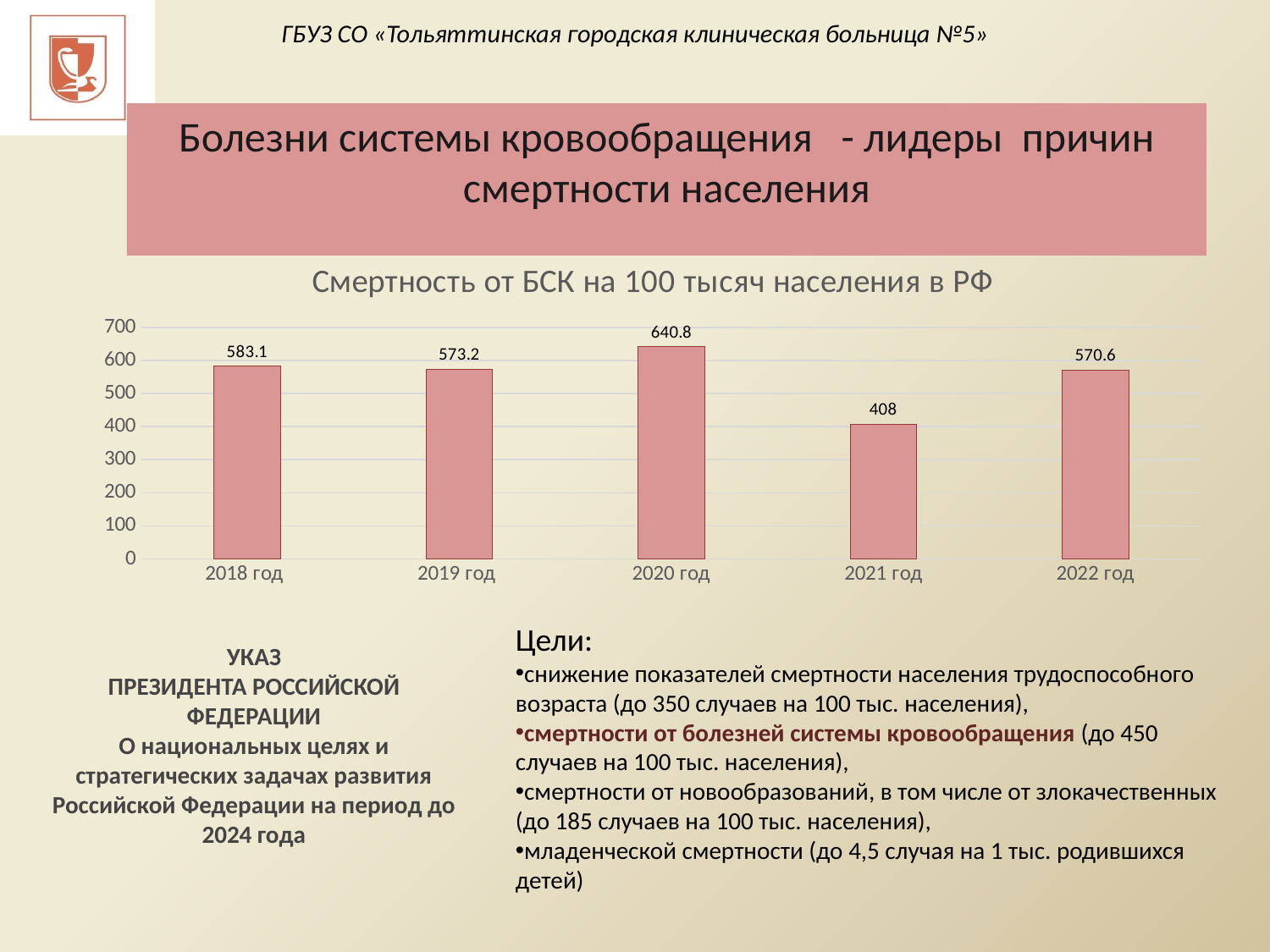
What is the value for 2022 год? 570.6 Is the value for 2021 год greater or less than 500? less Which year has the highest value? 2020 год What is the difference between the values for 2020 год and 2021 год? 232.8 What is the title of the chart? Смертность от БСК на 100 тысяч населения в РФ What is the value for 2018 год? 583.1 What is the value for 2021 год? 408 How many years are shown on the chart? 5 What is the difference between the values for 2018 год and 2019 год? 9.9 Which year has the lowest value? 2021 год Which is larger, the value for 2019 год or the value for 2022 год? 2019 год What kind of chart is shown on the slide? bar chart